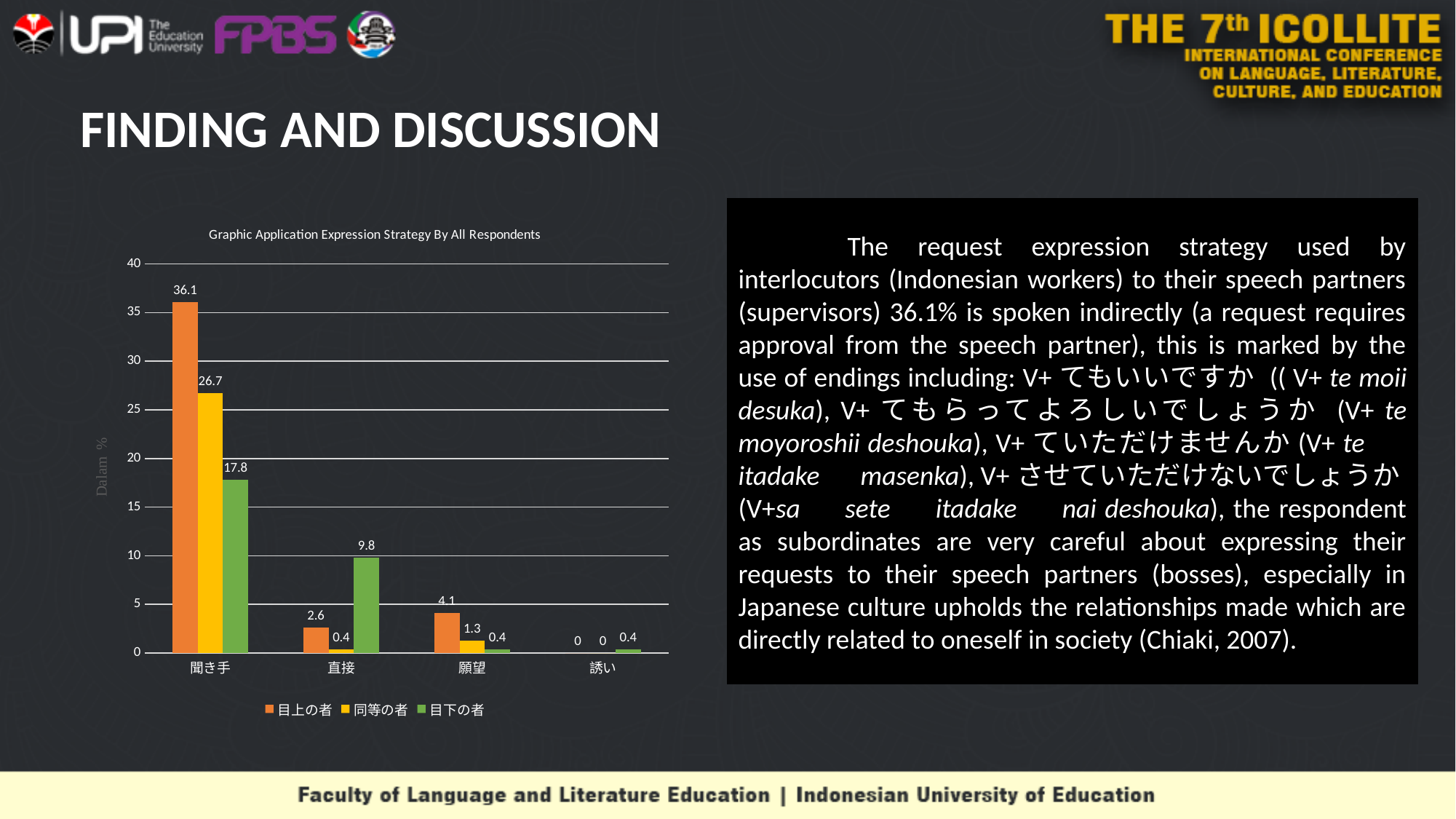
In the 直接 category, which is larger: 目上の者 or 目下の者? 目下の者 What is the difference between the 目上の者 and 同等の者 values in the 聞き手 category? 9.4 Which category has the highest value for the 目上の者 series? 聞き手 What is the value for 同等の者 in the 願望 category? 1.3 What kind of chart is shown on the slide? bar chart Which series has the lowest value in the 聞き手 category? 目下の者 What is the value for 目上の者 in the 聞き手 category? 36.1 What is the value for 目下の者 in the 直接 category? 9.8 What is the title of the chart? Graphic Application Expression Strategy By All Respondents How many categories are shown on the x axis? 4 How many series does the legend list? 3 Is the value for 目上の者 in the 聞き手 category greater or less than 35? greater